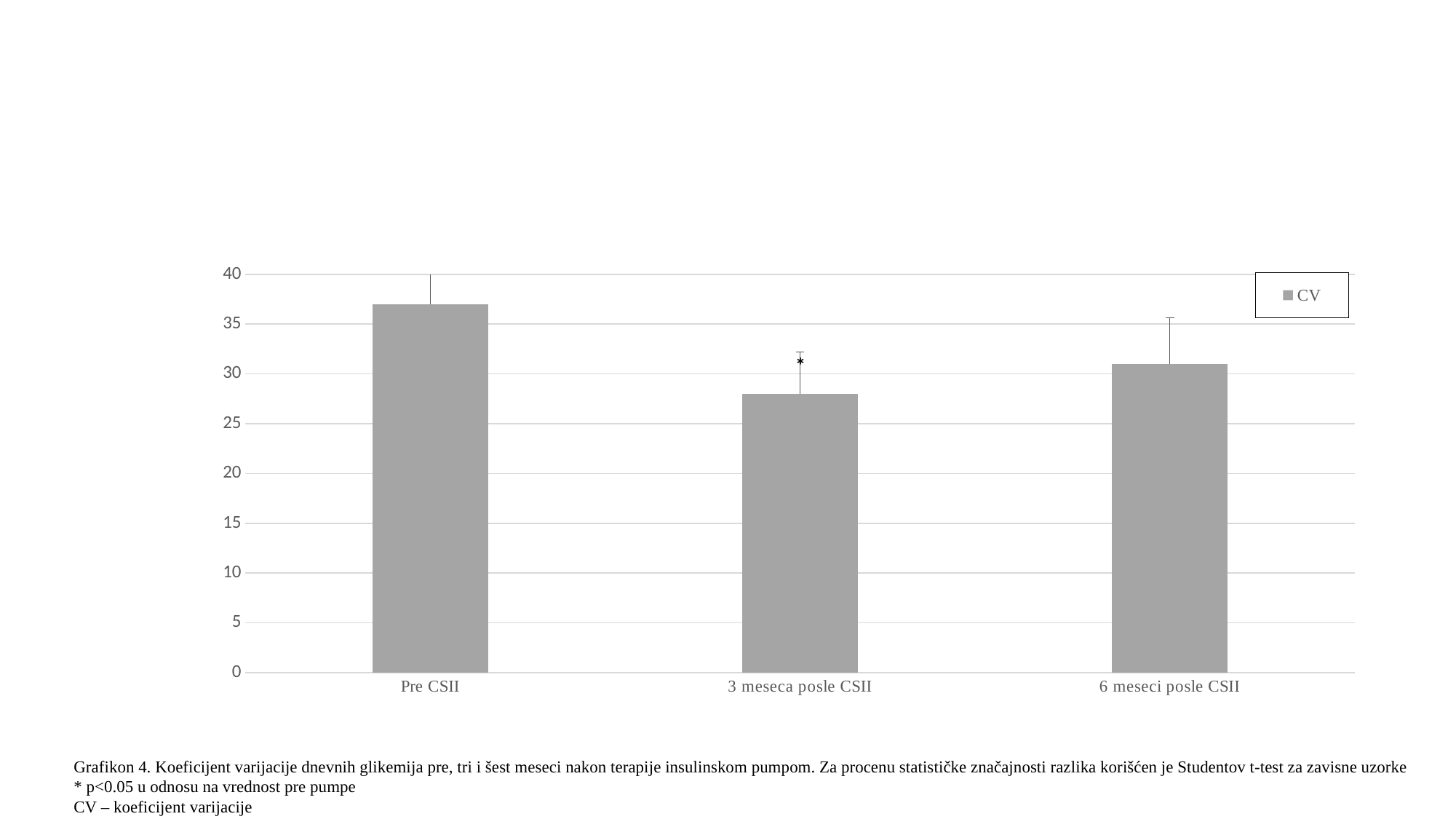
Which category has the highest CV value? Pre CSII What is the name of the series listed in the chart's legend? CV How many series does the chart's legend list? 1 Which has a larger CV value, Pre CSII or 3 meseca posle CSII? Pre CSII Is the CV value for Pre CSII greater or less than 35? greater Which has a larger CV value, 3 meseca posle CSII or 6 meseci posle CSII? 6 meseci posle CSII Does the CV value rise or fall from Pre CSII to 3 meseca posle CSII? fall Is the CV value for 3 meseca posle CSII greater or less than 30? less Which category has the lowest CV value? 3 meseca posle CSII What kind of chart is shown on the slide? bar chart How many categories are shown on the x axis of the chart? 3 Is the CV value for 6 meseci posle CSII greater or less than 35? less